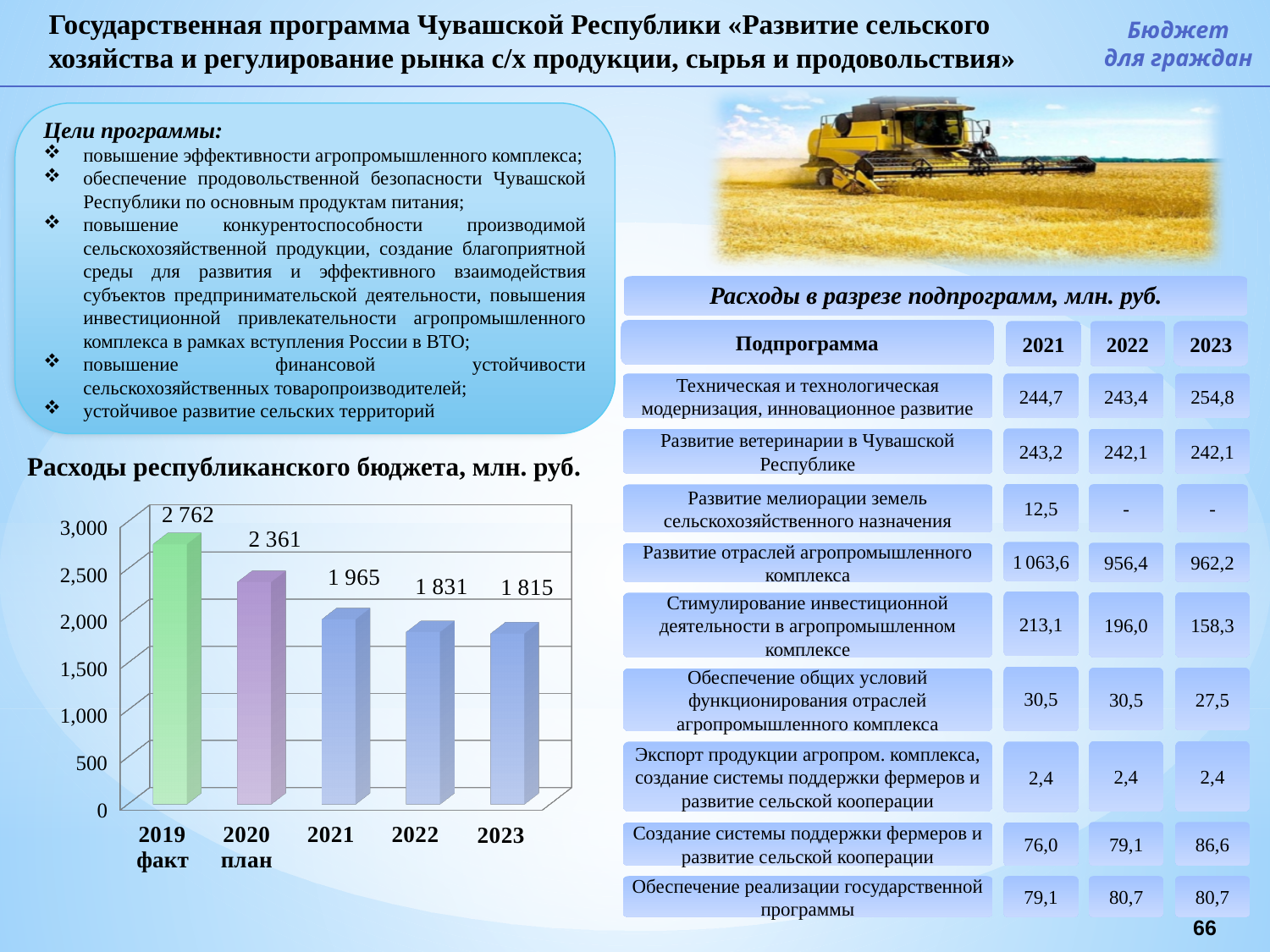
What is the value for 2020 план in the chart «Расходы республиканского бюджета, млн. руб.»? 2 361 What is the difference between the values for 2021 and 2022 in the chart «Расходы республиканского бюджета, млн. руб.»? 134 What kind of chart is «Расходы республиканского бюджета, млн. руб.»? bar chart Which is larger in the chart «Расходы республиканского бюджета, млн. руб.»: the value for 2020 план or the value for 2021? 2020 план Do the values rise or fall from 2019 факт to 2023 in the chart «Расходы республиканского бюджета, млн. руб.»? fall Which category has the highest value in the chart «Расходы республиканского бюджета, млн. руб.»? 2019 факт What is the value for 2023 in the chart «Расходы республиканского бюджета, млн. руб.»? 1 815 Which category has the lowest value in the chart «Расходы республиканского бюджета, млн. руб.»? 2023 What is the difference between the values for 2019 факт and 2020 план in the chart «Расходы республиканского бюджета, млн. руб.»? 401 How many categories are shown in the chart «Расходы республиканского бюджета, млн. руб.»? 5 What is the value for 2021 in the chart «Расходы республиканского бюджета, млн. руб.»? 1 965 What is the value for 2019 факт in the chart «Расходы республиканского бюджета, млн. руб.»? 2 762